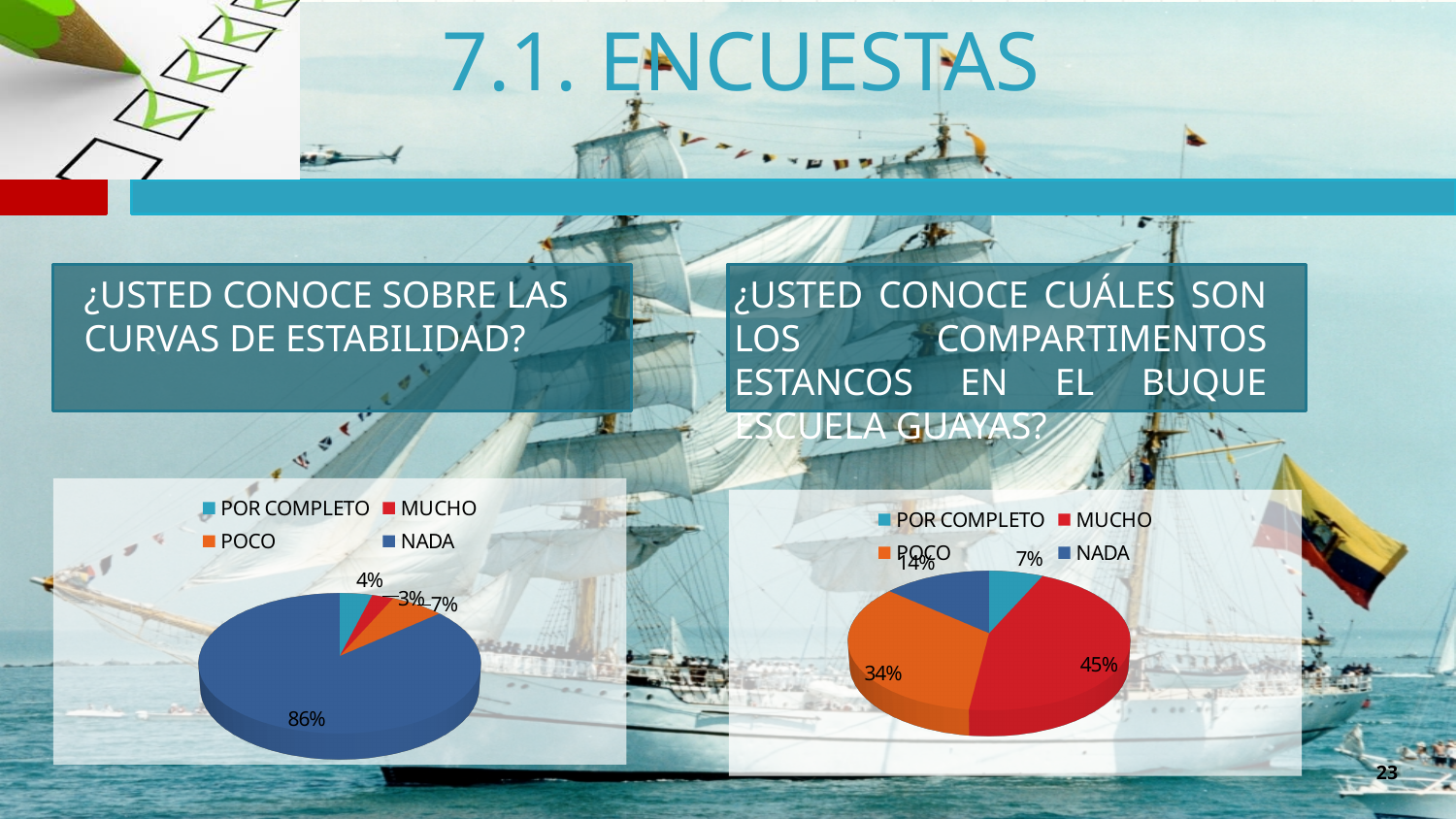
What type of chart is used on the left side of the slide? Pie chart In the left pie chart (curvas de estabilidad), how many series does the legend list? 4 In the left pie chart (curvas de estabilidad), what is the difference between the NADA share and the POCO share? 79% In the right pie chart (compartimentos estancos), what is the difference between the MUCHO share and the POCO share? 11% In the right pie chart (compartimentos estancos), what percentage is shown for MUCHO? 45% In the right pie chart (compartimentos estancos), which category has the largest share? MUCHO In the right pie chart (compartimentos estancos), which is larger, the share for POCO or the share for NADA? POCO In the right pie chart (compartimentos estancos), which category has the smallest share? POR COMPLETO In the left pie chart (curvas de estabilidad), what percentage is shown for NADA? 86% In the right pie chart (compartimentos estancos), what percentage is shown for NADA? 14% In the left pie chart (curvas de estabilidad), what percentage is shown for POCO? 7% In the left pie chart (curvas de estabilidad), which category has the smallest share? MUCHO